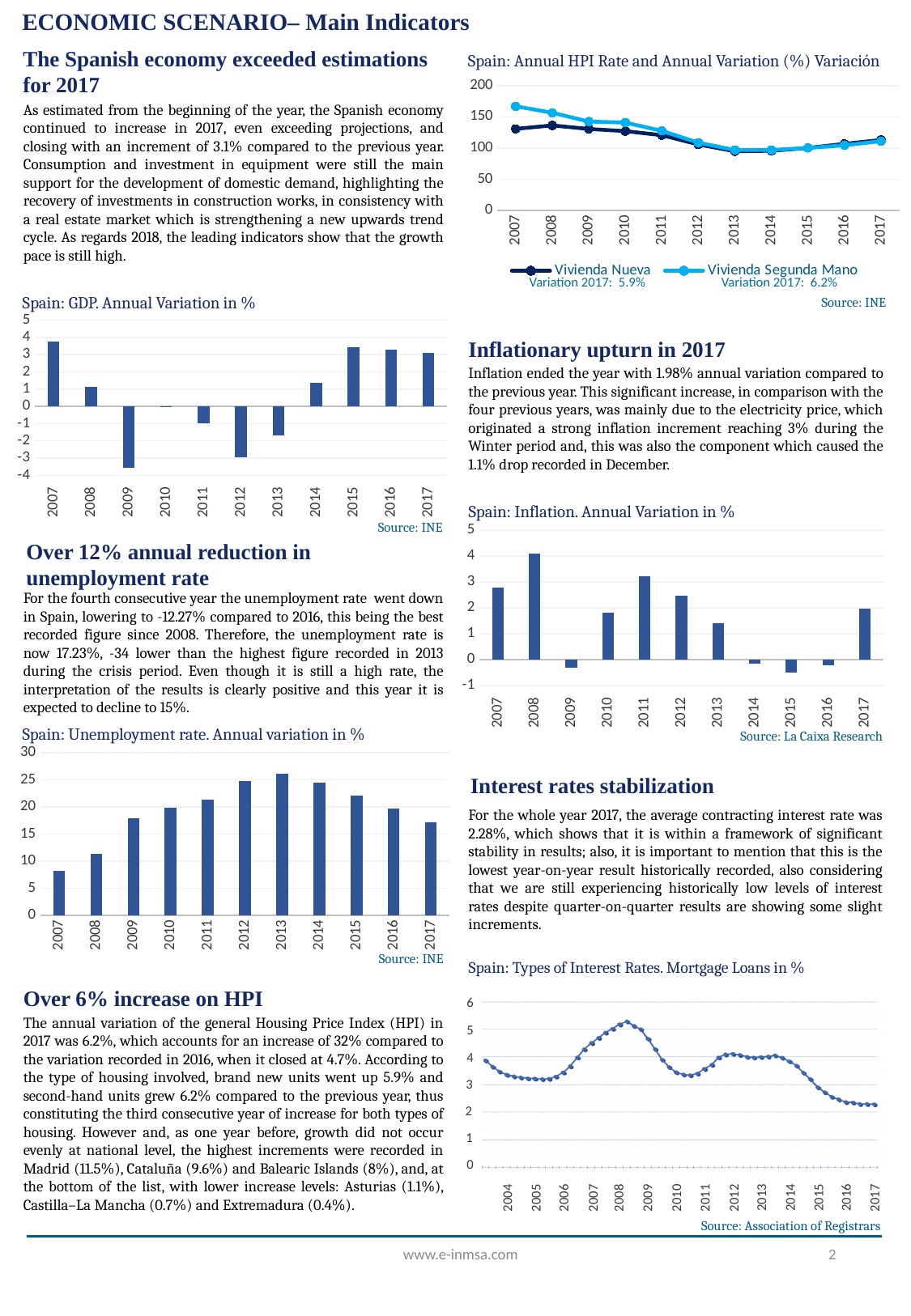
In the chart 'Spain: GDP. Annual Variation in %', is the value for 2009 greater or less than -3? less In the chart 'Spain: Inflation. Annual Variation in %', which year has the highest value? 2008 In the chart 'Spain: Inflation. Annual Variation in %', which year has the lowest value? 2015 What kind of chart is 'Spain: Types of Interest Rates. Mortgage Loans in %'? line chart How many series does the legend list in the chart 'Spain: Annual HPI Rate and Annual Variation (%) Variación'? 2 In the chart 'Spain: Annual HPI Rate and Annual Variation (%) Variación', which series has the higher value in 2007, Vivienda Nueva or Vivienda Segunda Mano? Vivienda Segunda Mano In the chart 'Spain: Unemployment rate. Annual variation in %', which year has the highest value? 2013 In the chart 'Spain: Unemployment rate. Annual variation in %', is the value for 2007 greater or less than 10? less In the chart 'Spain: Unemployment rate. Annual variation in %', which year has the lowest value? 2007 In the chart 'Spain: GDP. Annual Variation in %', which year has the highest value? 2007 How many years are shown on the x axis of the chart 'Spain: GDP. Annual Variation in %'? 11 In the chart 'Spain: GDP. Annual Variation in %', which year has the lowest value? 2009